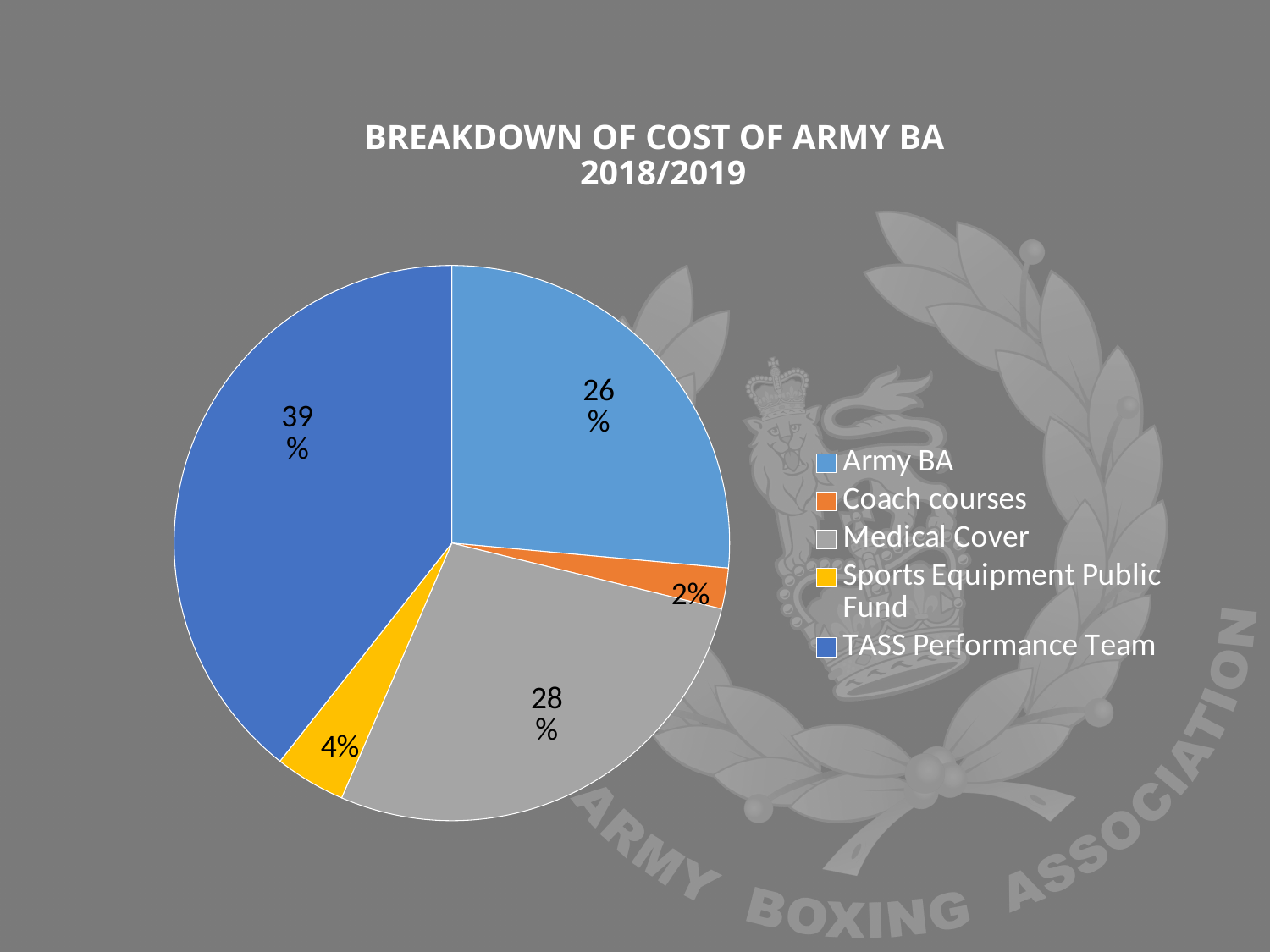
What is the difference in percentage points between TASS Performance Team and Army BA? 13 What is the title of the chart? BREAKDOWN OF COST OF ARMY BA 2018/2019 What share of the pie does Army BA represent? 26% Which category has the smallest share of the pie? Coach courses What share of the pie does Medical Cover represent? 28% What kind of chart is shown on the slide? pie chart Which category has the largest share of the pie? TASS Performance Team What share of the pie does TASS Performance Team represent? 39% How many categories does the pie chart show? 5 Which is larger, the share for Medical Cover or the share for Army BA? Medical Cover